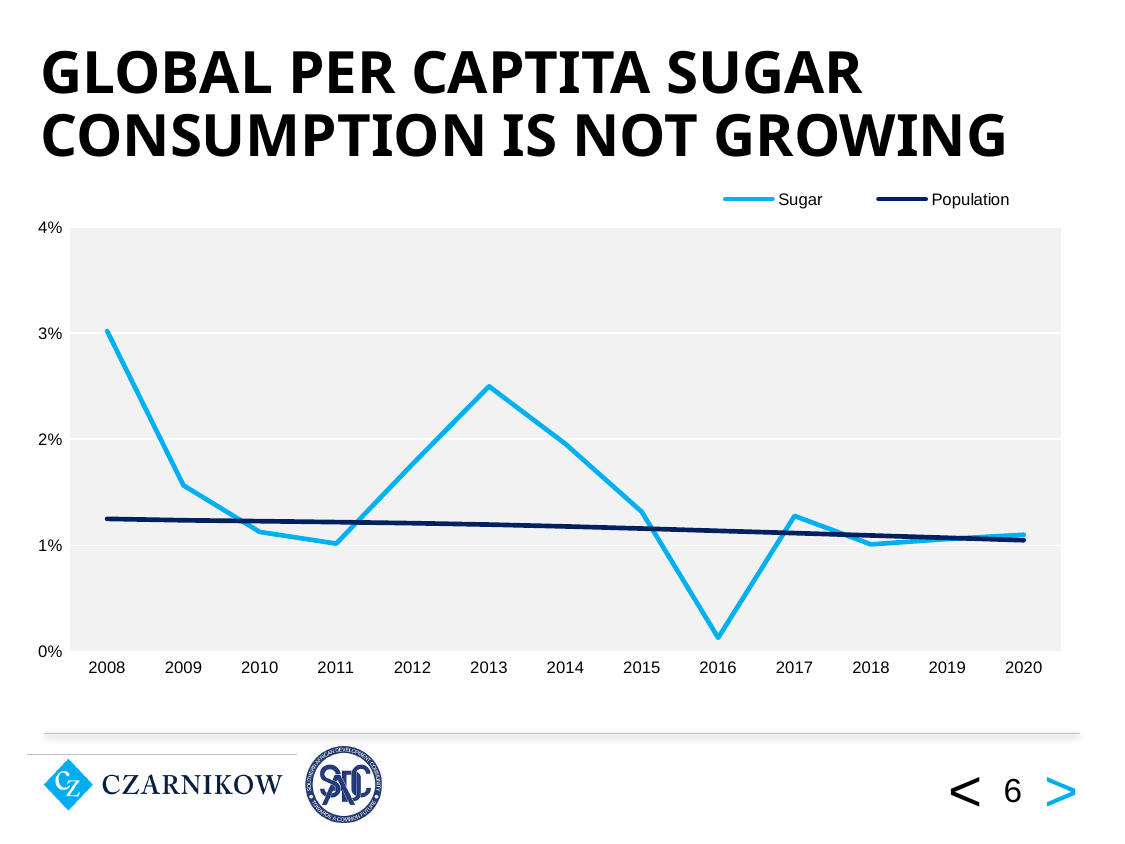
How many series does the legend list? 2 Does the Population line rise or fall from 2008 to 2020? fall What are the two series named in the legend? Sugar and Population Is the Sugar value for 2016 greater or less than 1%? less In which year is the Sugar series at its highest? 2008 Which is larger, the Sugar value for 2013 or the Sugar value for 2016? 2013 Is the Sugar value for 2008 greater or less than 2%? greater Is the Population value for 2008 greater or less than 2%? less What kind of chart is shown on the slide? line chart How many years are plotted along the x axis? 13 In which year is the Sugar series at its lowest? 2016